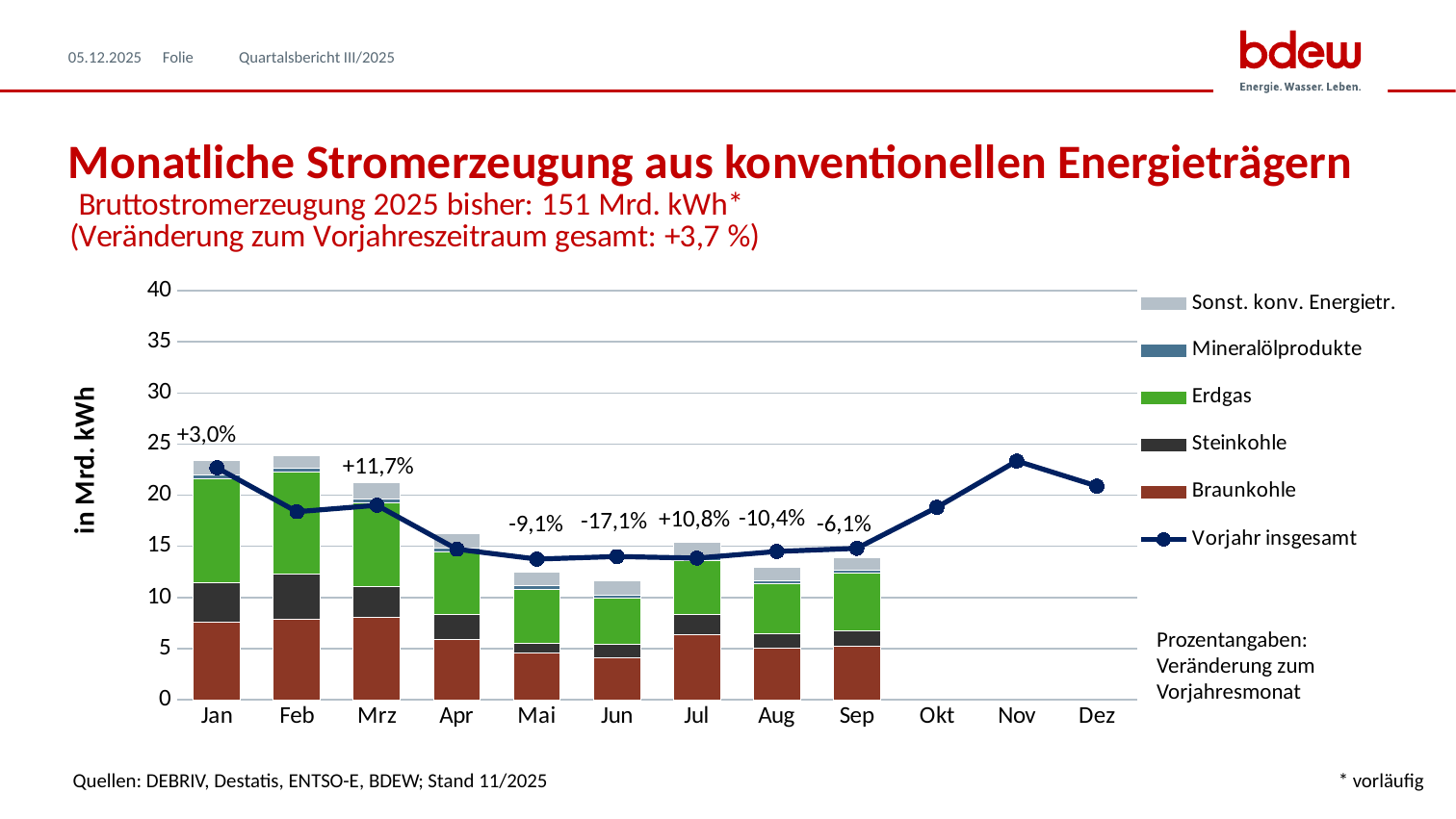
Is the total stacked bar for Jun greater or less than 15? less What percentage change is shown for Aug? -10,4% What percentage change is shown for Jun? -17,1% Is the total stacked bar for Jan greater or less than 20? greater What percentage change is shown for Jan? +3,0% How many entries does the legend list? 6 Do the stacked bars rise or fall from Jan to Jun? fall Which month has the lowest percentage change label? Jun Which month has the highest percentage change label? Mrz What percentage change is shown above the Mrz bar? +11,7% How many months have stacked bars plotted? 9 Which percentage change is larger, Mrz or Jul? Mrz